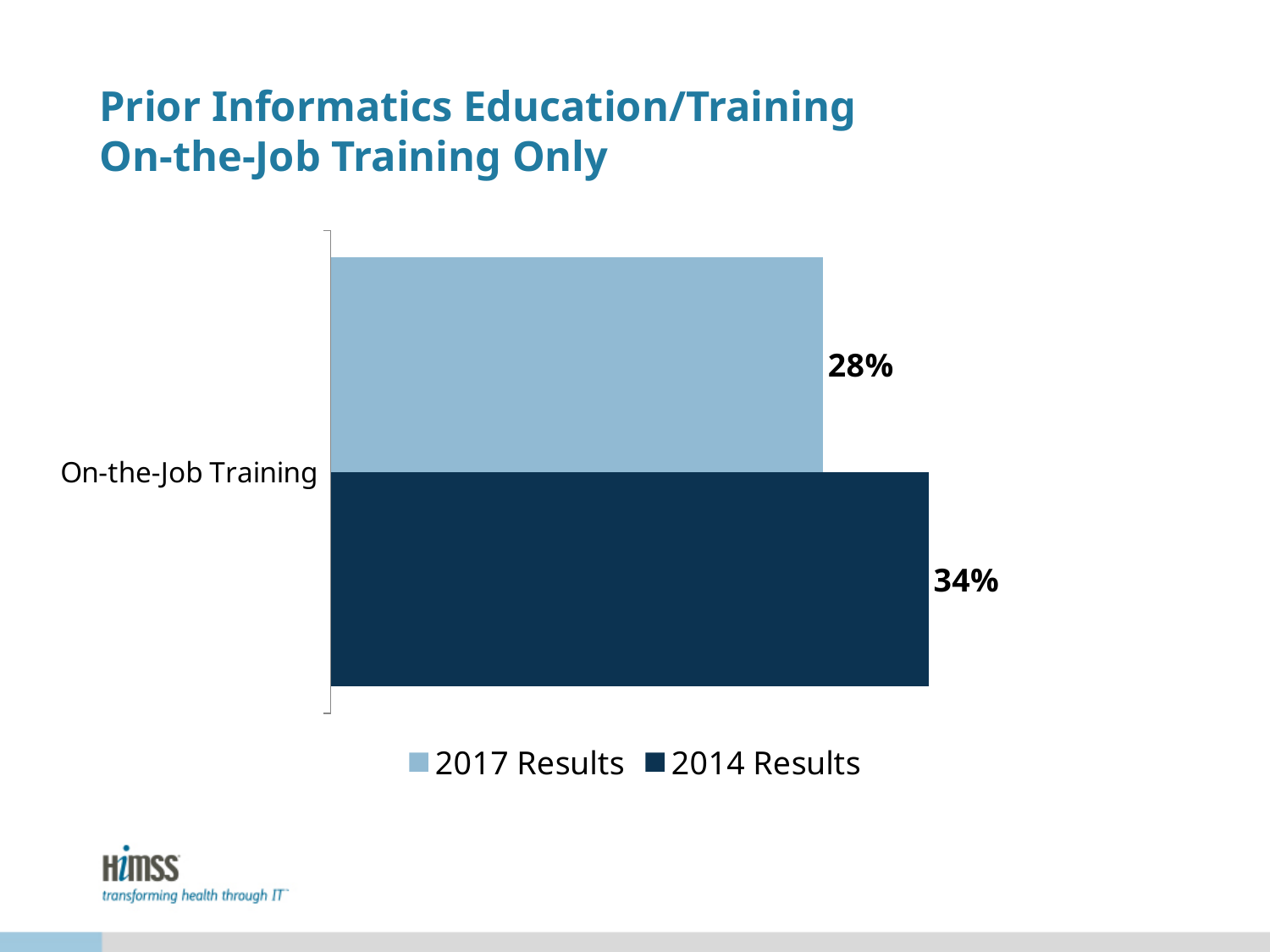
How many series does the legend list? 2 What is the 2014 Results value for On-the-Job Training? 34% Which series has the higher value for On-the-Job Training, 2017 Results or 2014 Results? 2014 Results Which series is shown in the darker blue colour? 2014 Results What is the 2017 Results value for On-the-Job Training? 28% Which series has the lowest value on the chart? 2017 Results What is the category label shown on the chart's axis? On-the-Job Training What kind of chart is shown on the slide? Bar chart Which series has the highest value on the chart? 2014 Results What is the difference between the 2014 Results and 2017 Results values for On-the-Job Training? 6% Did the On-the-Job Training value rise or fall from 2014 Results to 2017 Results? Fall How many categories are shown on the chart? 1